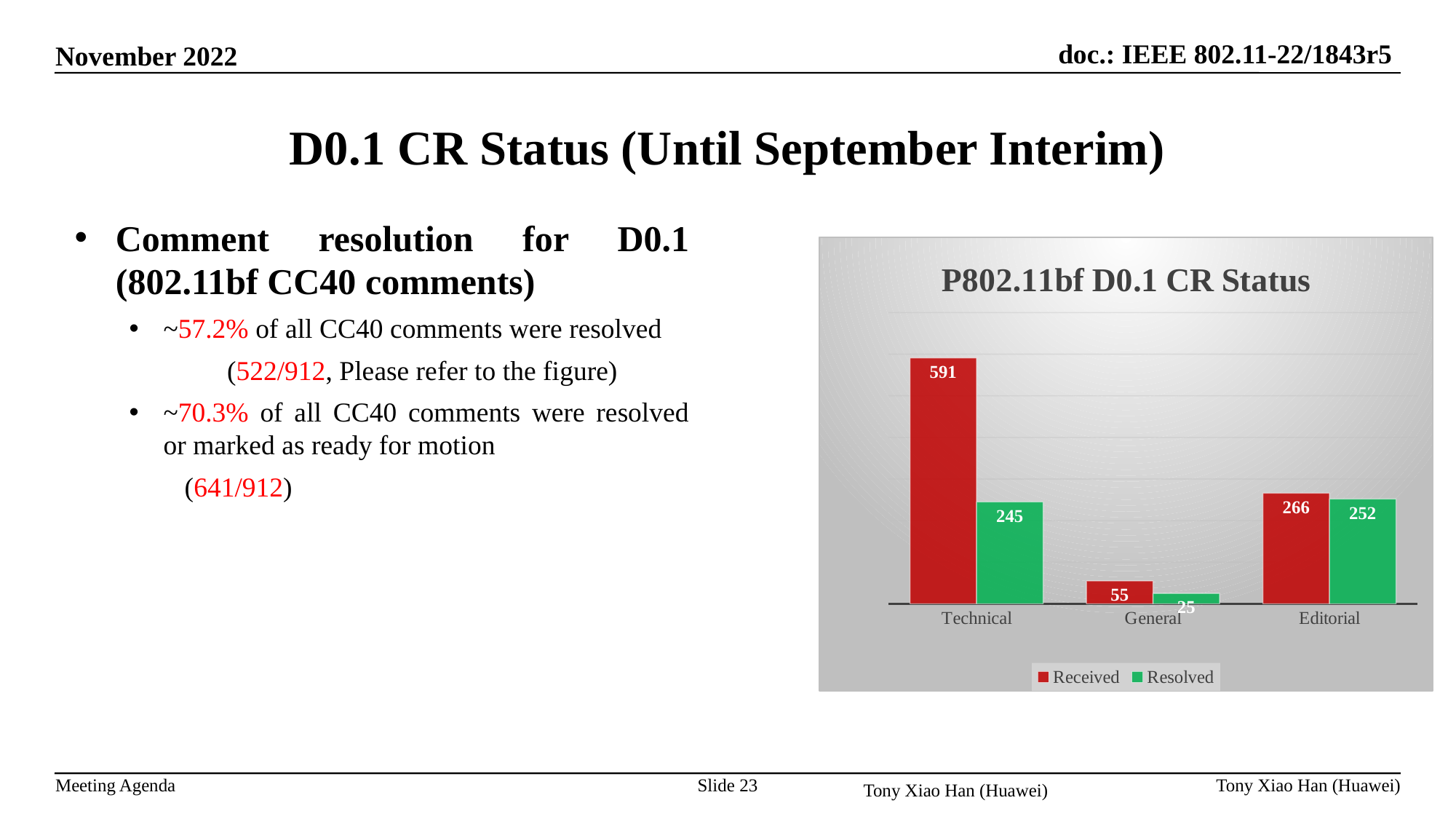
What is the title of the chart? P802.11bf D0.1 CR Status What kind of chart is shown? bar chart Which category has the lowest Resolved value? General How many series does the legend list? 2 What is the Resolved value for Editorial? 252 What is the Resolved value for General? 25 What is the difference between Received and Resolved for Technical? 346 Which is larger, the Resolved value for Technical or the Resolved value for Editorial? Editorial What is the Received value for Technical? 591 Which category has the highest Received value? Technical How many categories are shown on the x axis? 3 What is the difference between Received and Resolved for Editorial? 14